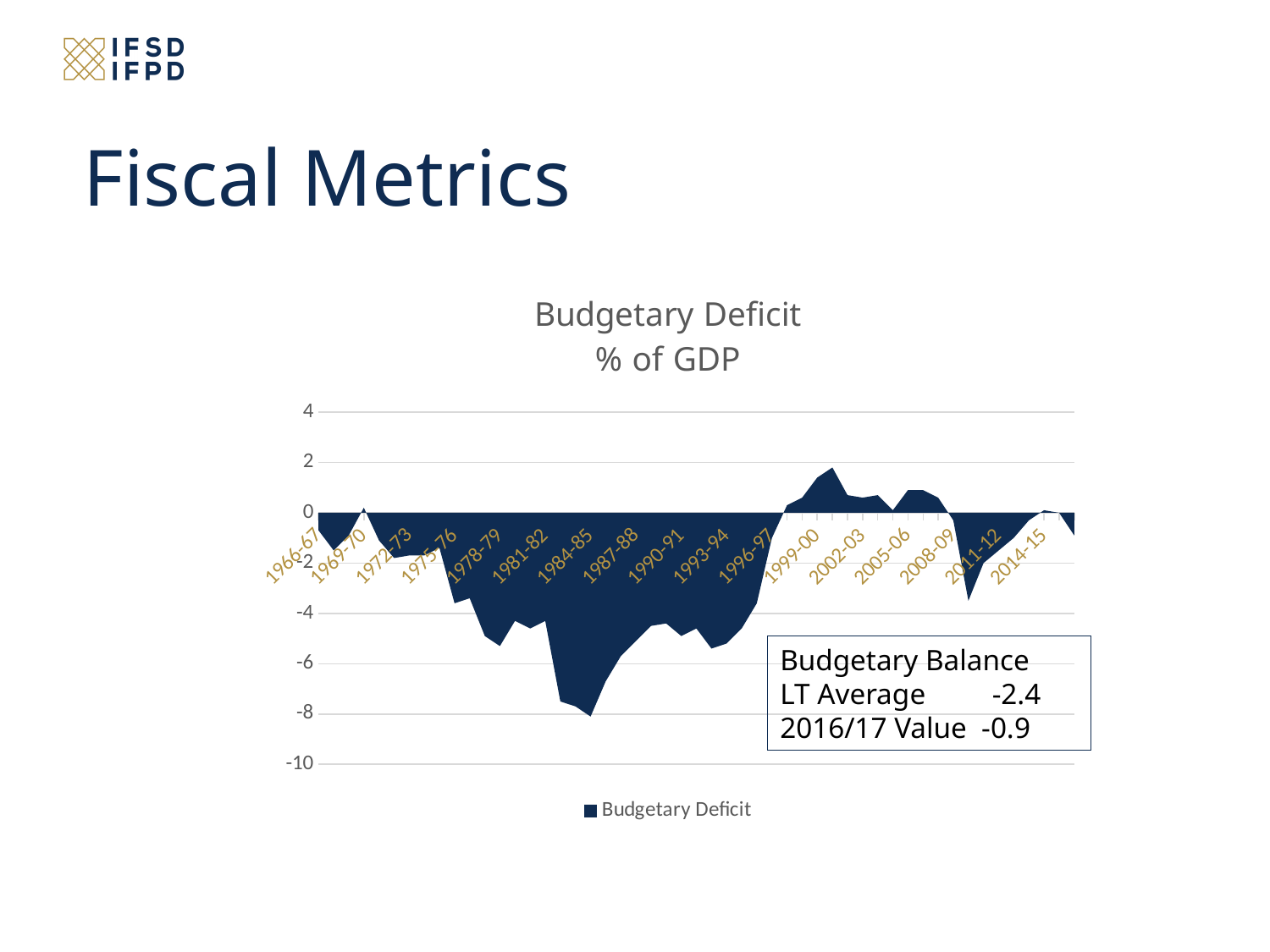
According to the text box on the chart, what is the long-term average budgetary balance? -2.4 Which of the labeled years has the lowest value, 1984-85 or 1975-76? 1984-85 How many series does the legend list? 1 Is the value for 1984-85 greater or less than -6? less Do the values generally rise or fall from 1984-85 to 1999-00? rise How many year labels are shown on the x axis? 17 Which is larger, the value for 2002-03 or the value for 1990-91? 2002-03 Is the value for 1966-67 greater or less than -2? greater Is the value for 2002-03 greater or less than 0? greater What is the title of the chart? Budgetary Deficit % of GDP What kind of chart is shown on the slide? area chart